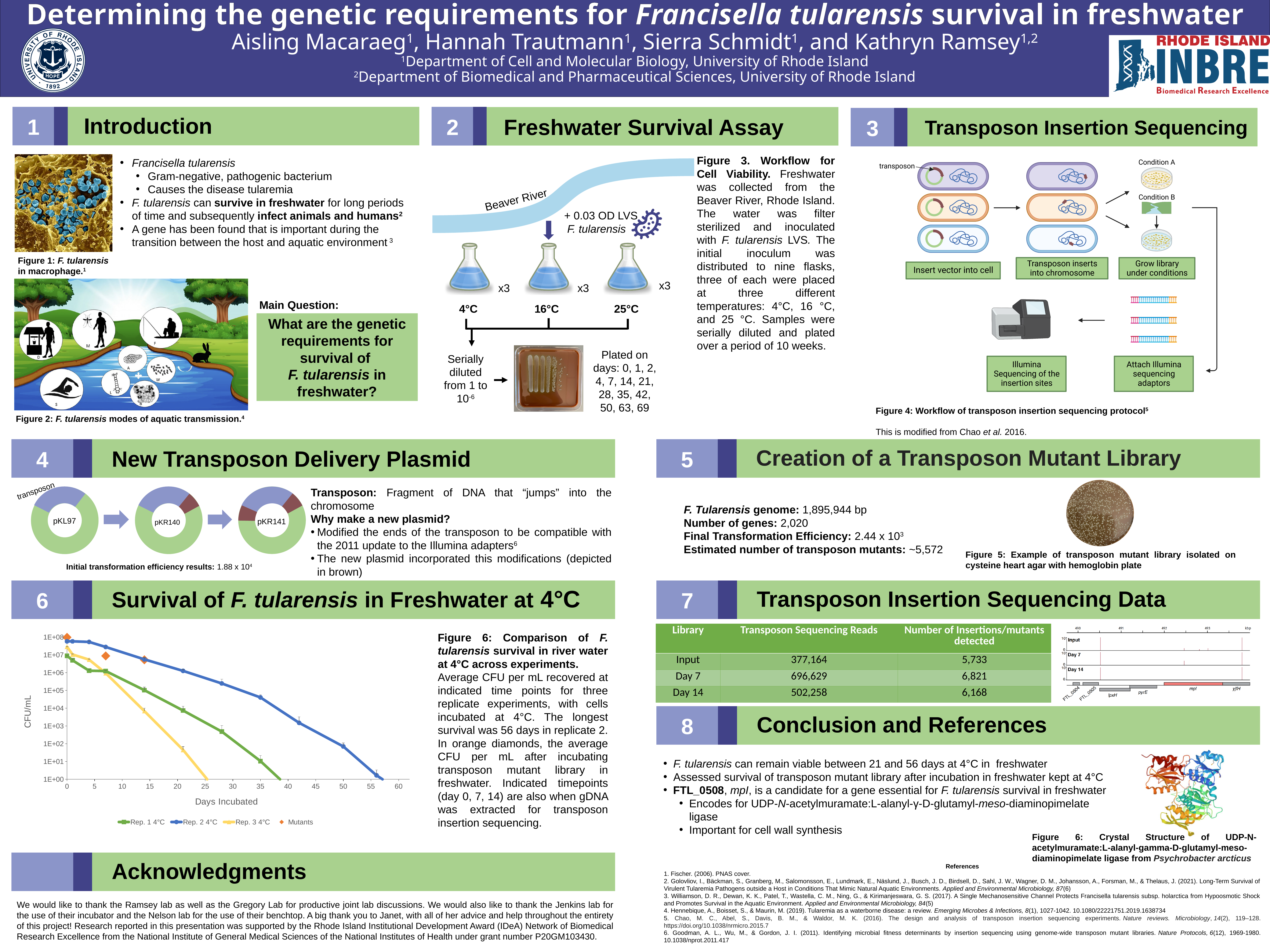
In the Figure 6 chart, which replicate series reaches 1E+00 CFU/mL at the earliest day? Rep. 3 4°C In the Figure 6 chart, is the value for Rep. 2 4°C at day 35 greater or less than 1E+04? greater In the Figure 6 chart, at day 35, which is larger: the value for Rep. 1 4°C or Rep. 2 4°C? Rep. 2 4°C What is the label of the y axis of the Figure 6 chart? CFU/mL In the Figure 6 chart, do the CFU/mL values for the replicates rise or fall as days incubated increase? fall In the Figure 6 chart, is the value for Rep. 3 4°C at day 21 greater or less than 1E+02? less In the Figure 6 chart, how many data points are plotted for the Mutants series? 3 How many series does the legend of the Figure 6 chart list? 4 In the Figure 6 chart, which replicate series reaches 1E+00 CFU/mL at the latest day? Rep. 2 4°C What is the label of the x axis of the Figure 6 chart? Days Incubated In the Figure 6 chart, at day 14, which is larger: the value for Rep. 2 4°C or Rep. 3 4°C? Rep. 2 4°C What kind of chart is shown in Figure 6 (Survival of F. tularensis in Freshwater at 4°C)? line chart